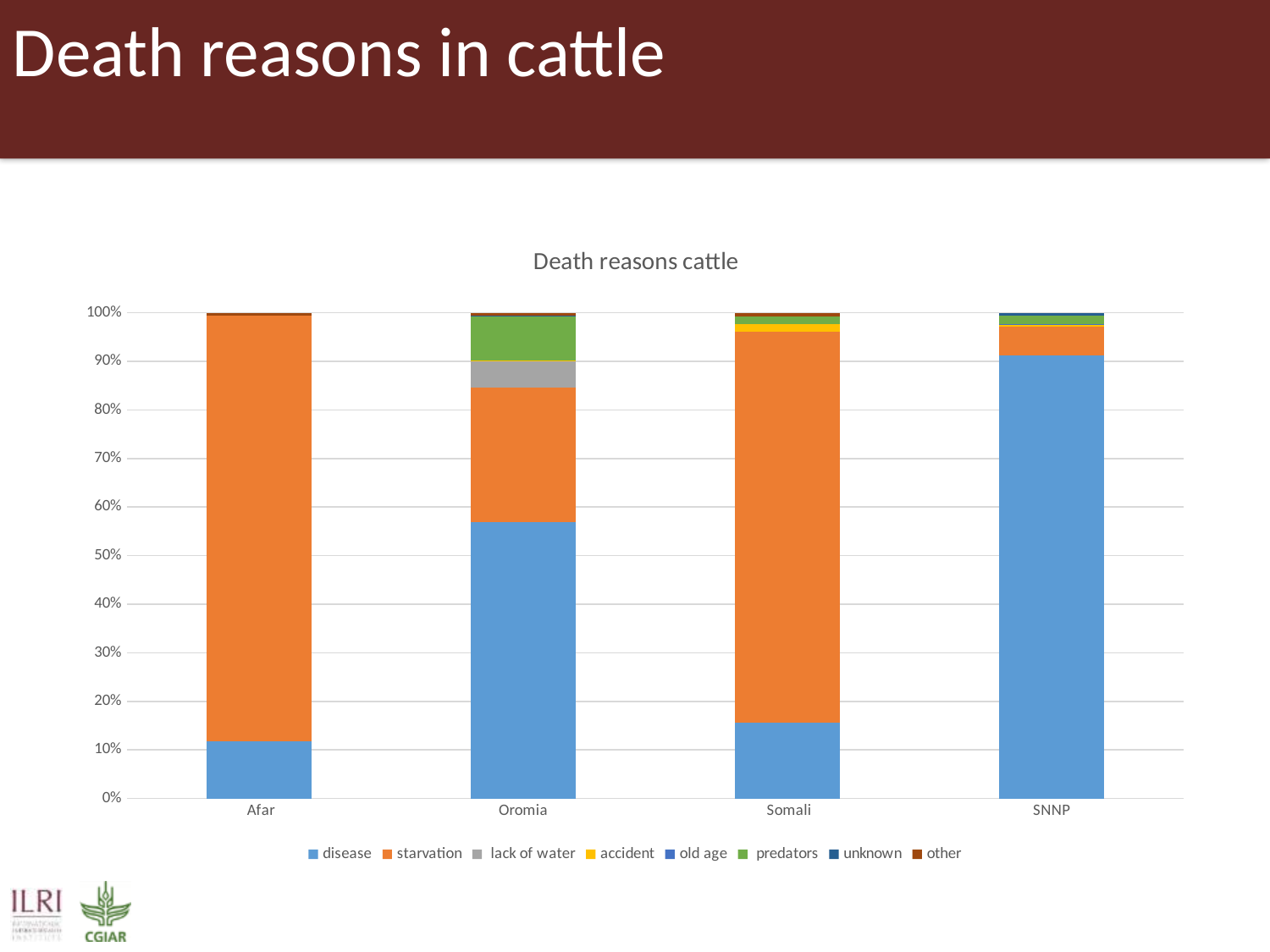
Is the share of deaths due to disease in SNNP greater or less than 80%? greater How many series does the legend list? 8 Is the share of deaths due to disease in Oromia greater or less than 50%? greater Which region has the largest share of deaths due to starvation? Afar Which region has a larger share of deaths due to disease, Somali or Oromia? Oromia What kind of chart is shown on the slide? stacked bar chart What is the title of the chart? Death reasons cattle Which region has the largest share of deaths due to disease? SNNP How many regions (categories) are shown on the x axis? 4 Which region has the smallest share of deaths due to disease? Afar Is the share of deaths due to disease in Afar greater or less than 20%? less Which region has the smallest share of deaths due to starvation? SNNP